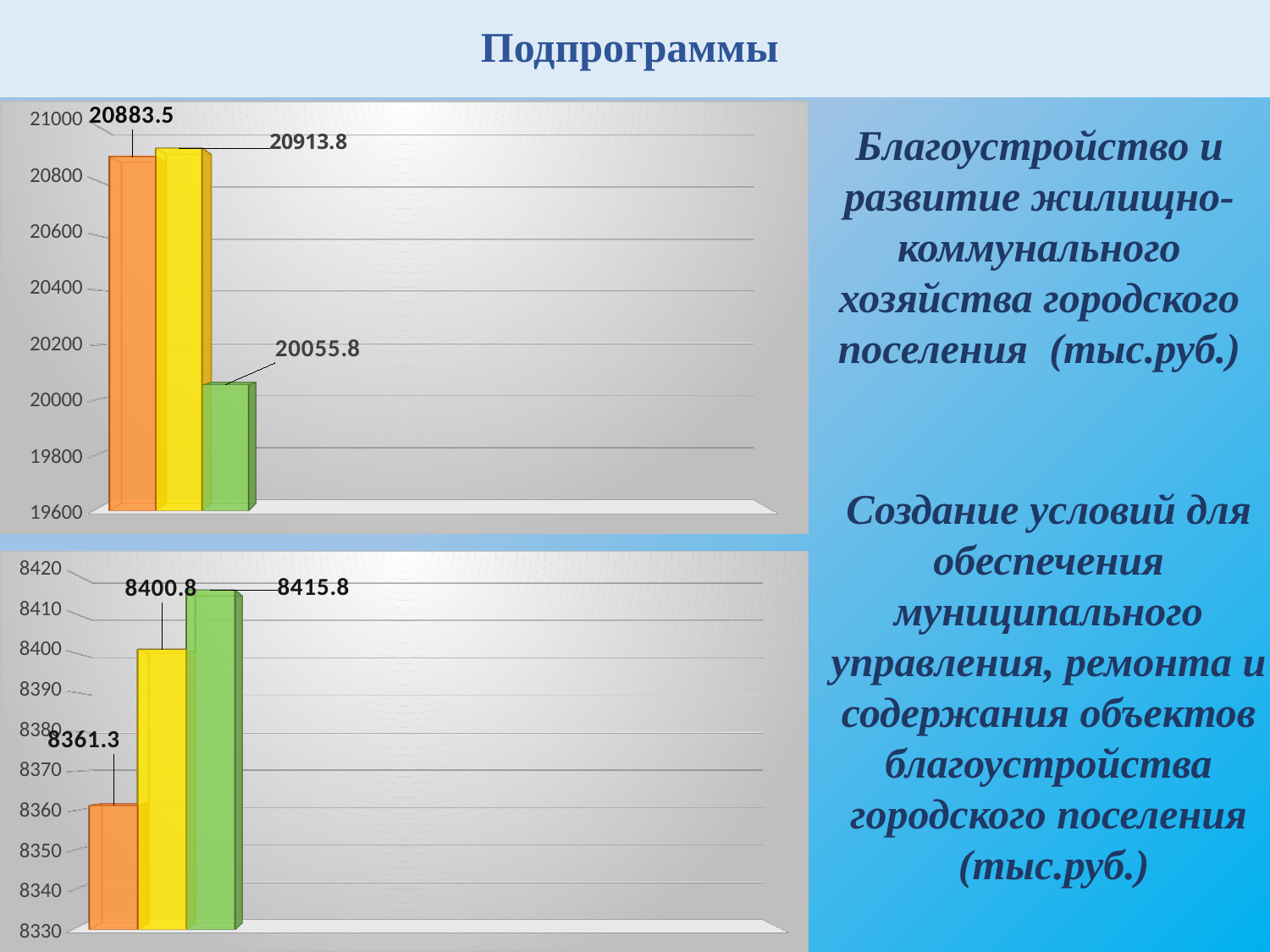
On the top chart, which bar has the lowest value? the green bar (20055.8) On the bottom chart, what is the value shown for the yellow bar? 8400.8 What kind of chart is the bottom chart? bar chart On the top chart, what is the value shown for the green bar? 20055.8 On the top chart, what is the difference between the yellow bar and the green bar? 858.0 On the bottom chart, what is the value shown for the orange bar? 8361.3 On the top chart, which bar has the highest value? the yellow bar (20913.8) On the bottom chart, which bar has the highest value? the green bar (8415.8) On the top chart, how many bars are plotted? 3 On the bottom chart, do the values rise or fall from left to right? rise On the top chart, what is the value shown for the orange bar? 20883.5 On the bottom chart, what is the difference between the green bar and the orange bar? 54.5